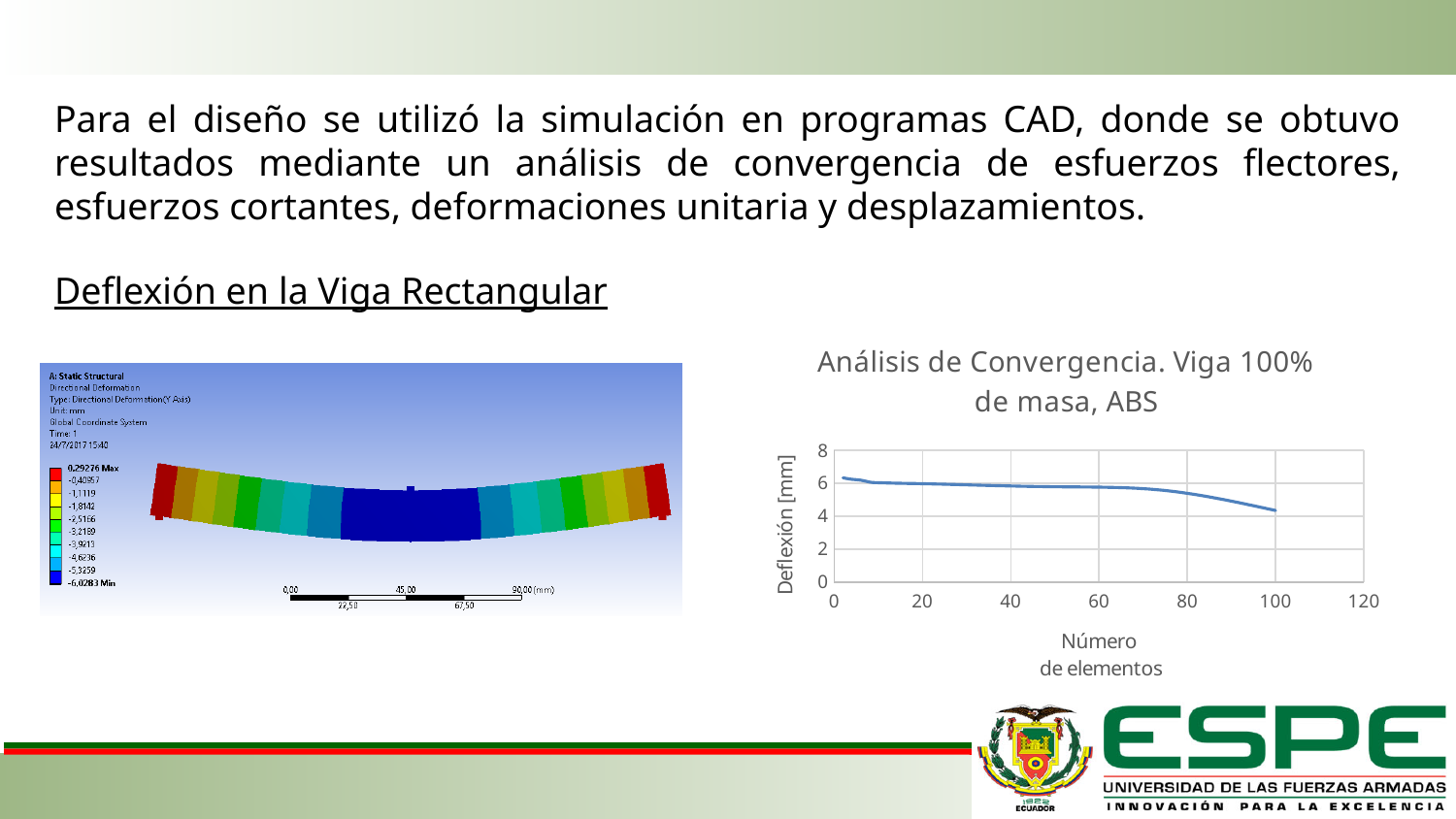
In the 'Análisis de Convergencia' chart, is the deflection at 20 elements greater or less than 4? greater In the 'Análisis de Convergencia' chart, does the deflection rise or fall as the number of elements increases? fall In the 'Análisis de Convergencia' chart, is the deflection at 20 elements greater or less than 8? less What is the title of the line chart on the slide? Análisis de Convergencia. Viga 100% de masa, ABS What is the y-axis label of the 'Análisis de Convergencia' chart? Deflexión [mm] In the 'Análisis de Convergencia' chart, which has the larger deflection: 20 elements or 100 elements? 20 elements What kind of chart is the 'Análisis de Convergencia. Viga 100% de masa, ABS' chart? line chart In the 'Análisis de Convergencia' chart, is the deflection at 100 elements greater or less than 6? less In the 'Análisis de Convergencia' chart, which has the smaller deflection: 40 elements or 100 elements? 100 elements